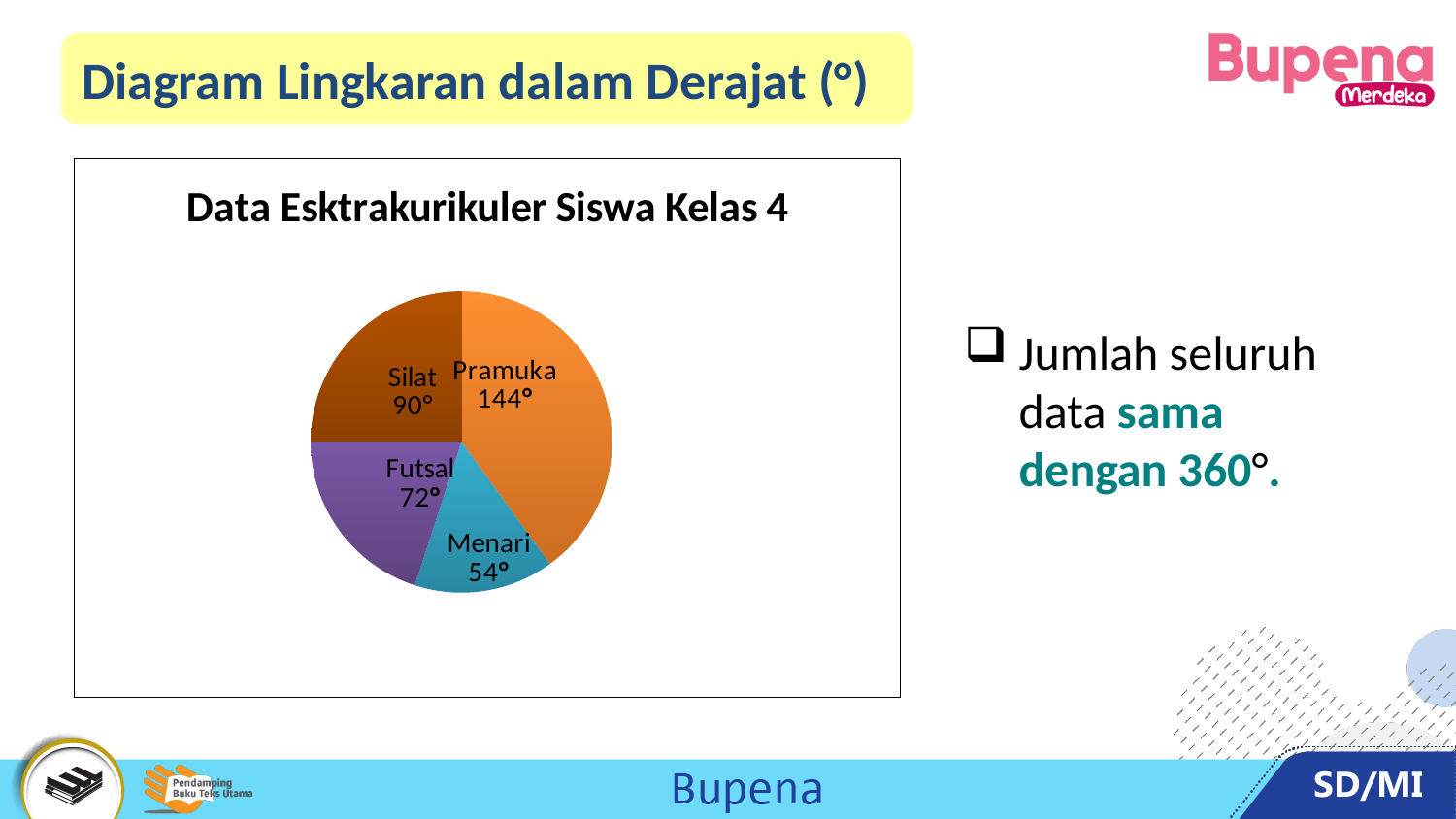
What is the difference between the values for Futsal and Menari? 18° How many categories are shown in the pie chart? 4 What is the value for Futsal in the pie chart? 72° What is the title of the chart? Data Esktrakurikuler Siswa Kelas 4 Which category has the smallest slice in the pie chart? Menari What kind of chart is shown on the slide? Pie chart What is the value for Menari in the pie chart? 54° What is the difference between the values for Pramuka and Silat? 54° What is the value for Pramuka in the pie chart? 144° What is the value for Silat in the pie chart? 90° Which category has the largest slice in the pie chart? Pramuka Which is larger, the value for Silat or the value for Futsal? Silat